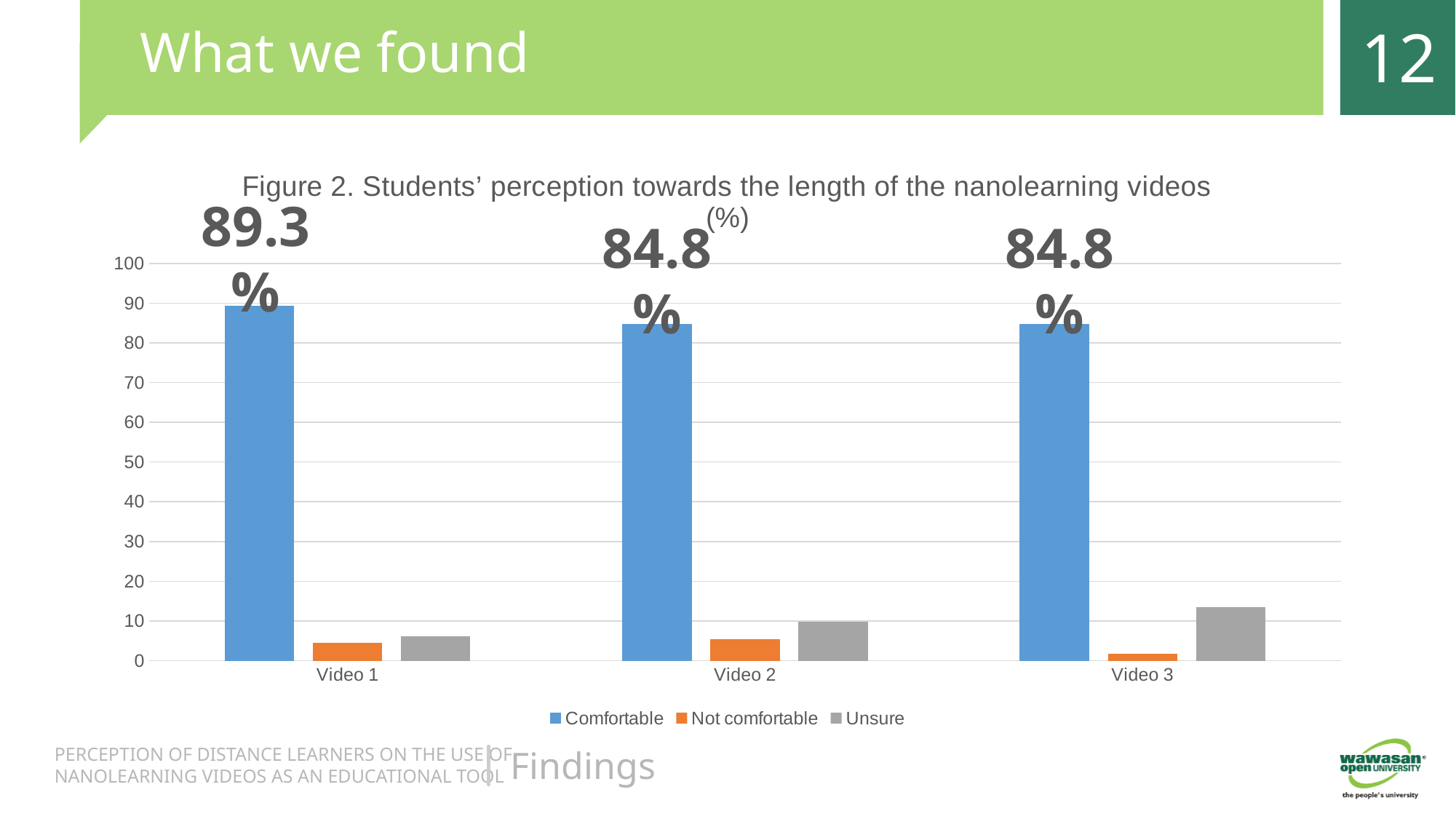
Is the Unsure value for Video 3 greater or less than 10? greater Is the Unsure value for Video 1 greater or less than 10? less What is the value for Comfortable for Video 2? 84.8% What kind of chart is shown on the slide? Bar chart Which video has the highest Comfortable value? Video 1 For Video 3, which is larger, the Unsure value or the Not comfortable value? Unsure What is the value for Comfortable for Video 1? 89.3% How many video categories are shown on the x axis? 3 How many series does the legend list? 3 Which is larger, the Comfortable value for Video 1 or for Video 3? Video 1 What is the value for Comfortable for Video 3? 84.8% What is the difference between the Comfortable values for Video 1 and Video 2? 4.5%